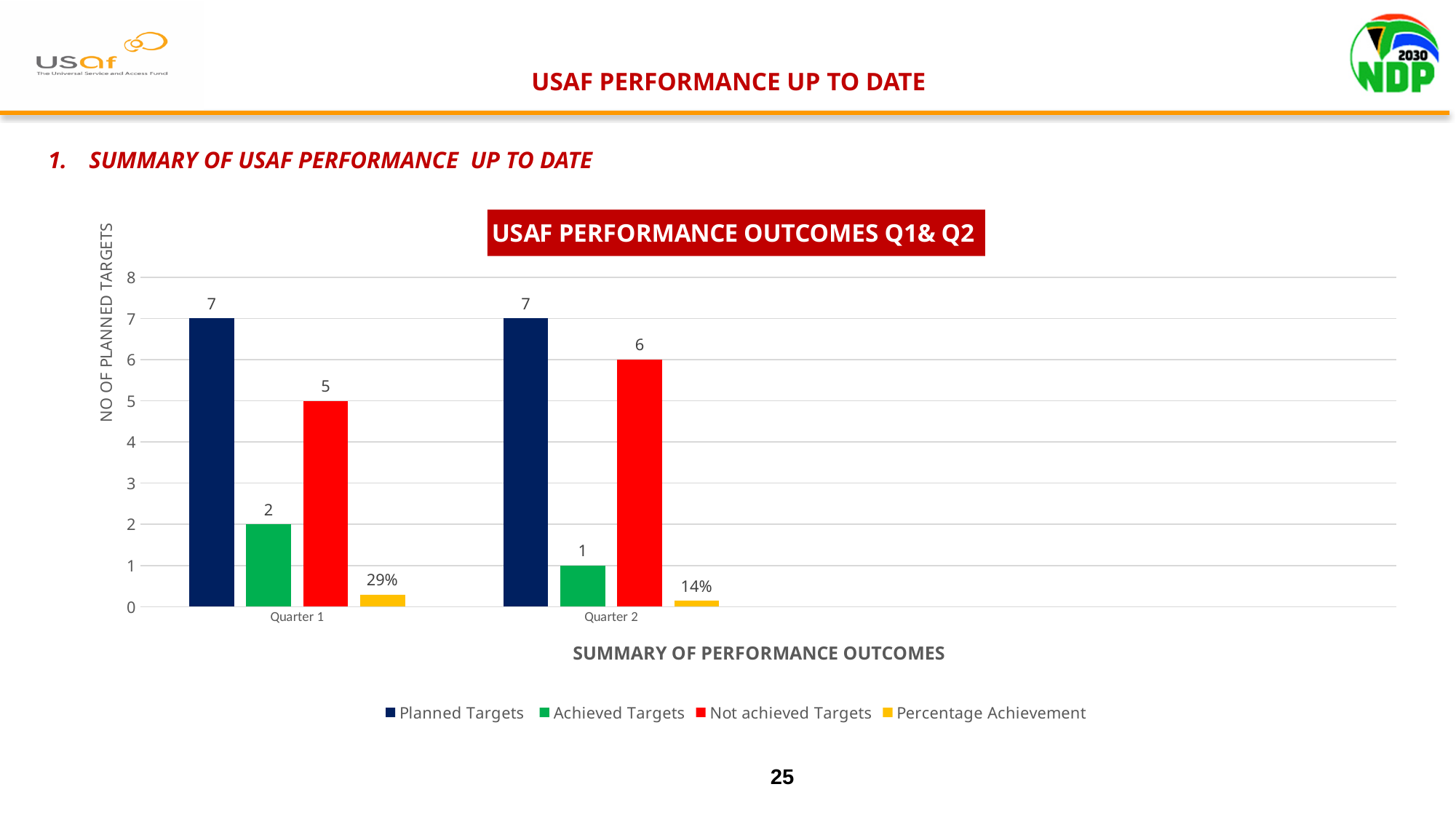
What is the difference between Not achieved Targets in Quarter 2 and Quarter 1? 1 What is the value of Planned Targets for Quarter 1? 7 How many series does the legend list? 4 What is the Percentage Achievement for Quarter 1? 29% What kind of chart is shown on the slide? Bar chart Which quarter has the lower value for Achieved Targets? Quarter 2 Is the value for Achieved Targets in Quarter 1 larger or smaller than the value for Not achieved Targets in Quarter 1? smaller What is the Percentage Achievement for Quarter 2? 14% What is the title of the chart? USAF PERFORMANCE OUTCOMES Q1& Q2 What is the value of Not achieved Targets for Quarter 2? 6 What is the value of Achieved Targets for Quarter 2? 1 Which quarter has the higher value for Not achieved Targets? Quarter 2